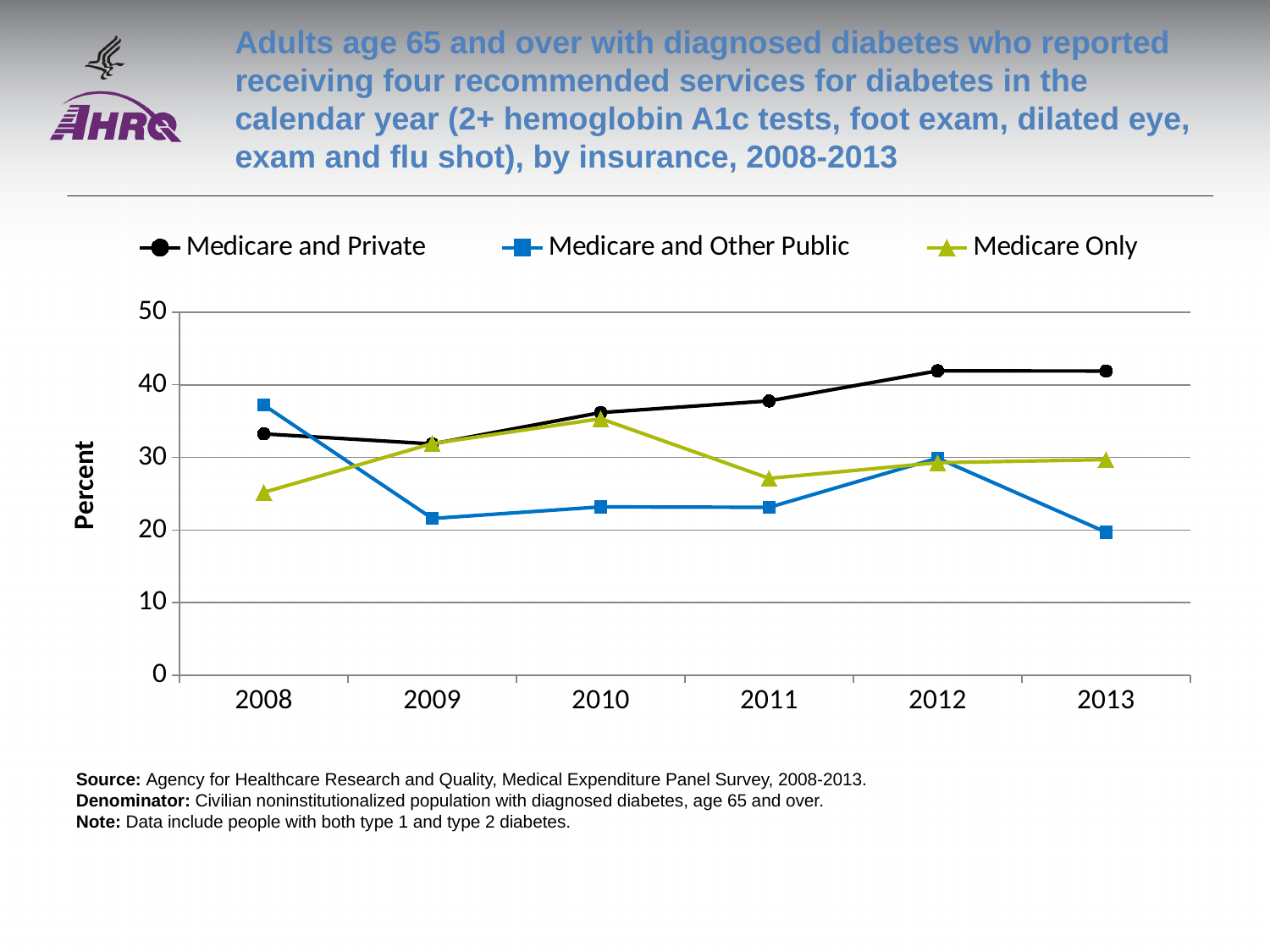
Is the value for Medicare and Private in 2012 greater or less than 40? greater Is the value for Medicare and Other Public in 2009 greater or less than 30? less Which insurance group has the lowest value in 2013? Medicare and Other Public In 2008, which is larger: Medicare and Other Public or Medicare Only? Medicare and Other Public Does the Medicare and Private line rise or fall from 2009 to 2012? rise What is the label on the y axis? Percent Which insurance group has the highest value in 2013? Medicare and Private How many series does the legend list? 3 In which year is the Medicare and Other Public value highest? 2008 What kind of chart is shown on the slide? line chart How many years are plotted along the x axis? 6 Is the value for Medicare Only in 2008 greater or less than 30? less